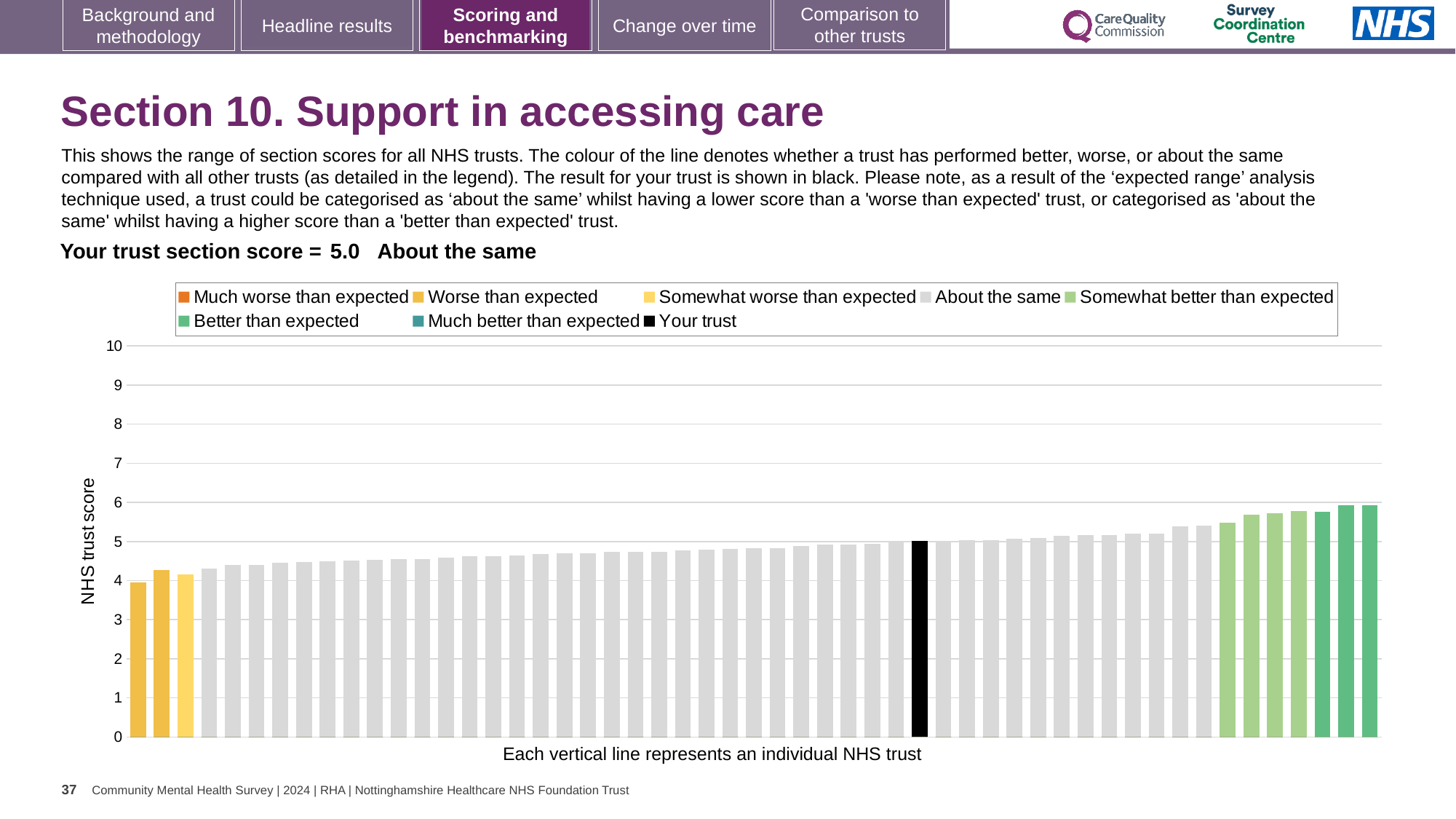
Is the value for your trust (black bar) greater or less than 4? greater Is the value of the shortest bar greater or less than 5? less How many entries does the chart legend list? 8 Which is larger, the leftmost bar or the rightmost bar? the rightmost bar What colour is the bar representing your trust? black Which category is your trust placed in for this section? About the same How many bars are coloured in the 'worse than expected' shades (orange/yellow)? 3 Do the bar values rise or fall from left to right along the x axis? rise What kind of chart is shown on the slide? bar chart What is the section score for your trust shown on the slide? 5.0 What is the label on the y axis of the chart? NHS trust score Is the value of the tallest bar greater or less than 5? greater